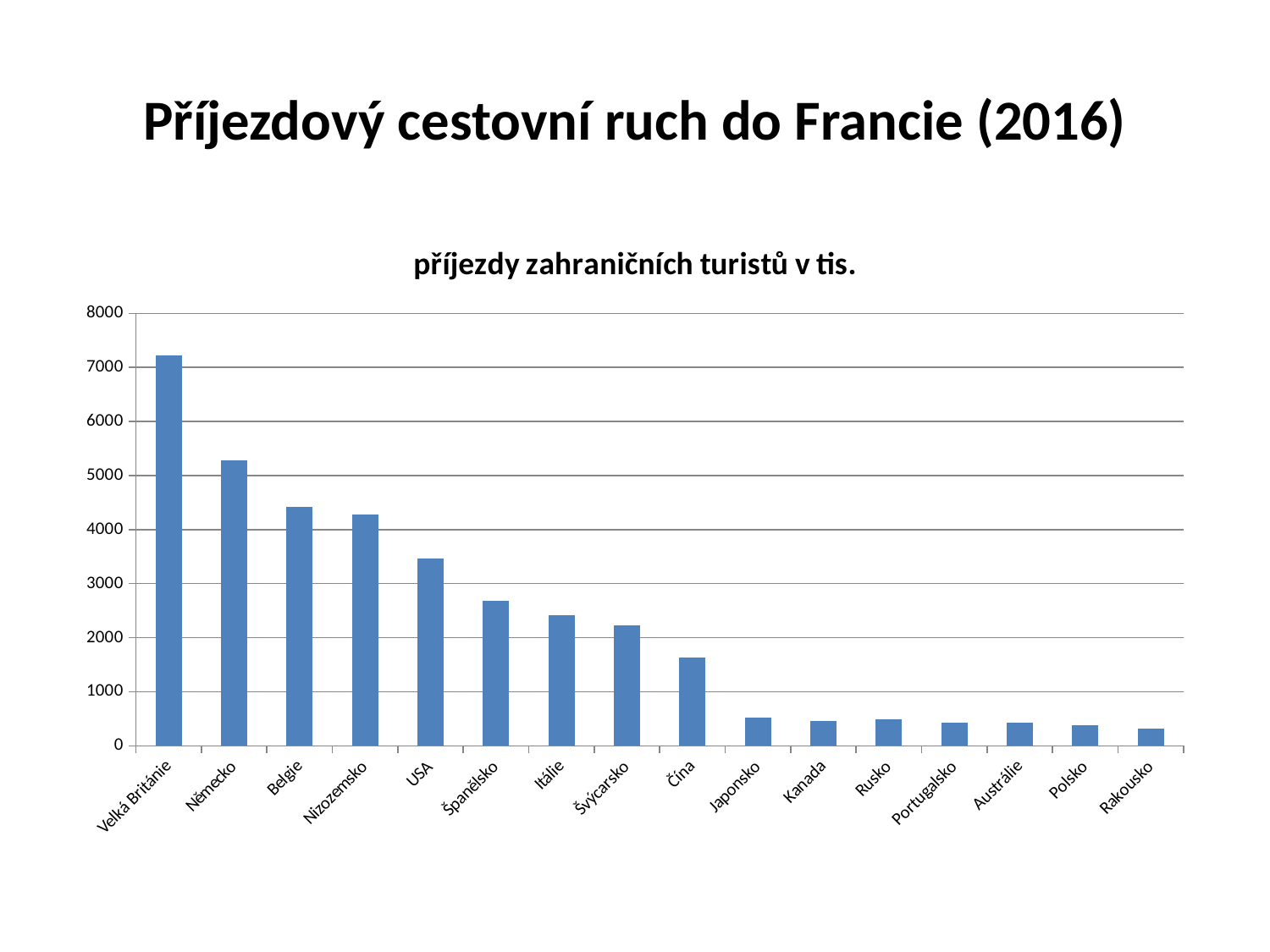
Is the value for Španělsko greater or less than 3000? less Do the values rise or fall from left to right along the x axis? fall Is the value for USA greater or less than 4000? less Is the value for Čína greater or less than 1000? greater Which country has the lowest number of tourist arrivals in the chart? Rakousko What kind of chart is shown on the slide? bar chart Which has a higher value, Německo or Belgie? Německo Which country has the highest number of tourist arrivals in the chart? Velká Británie How many countries are shown on the x axis of the chart? 16